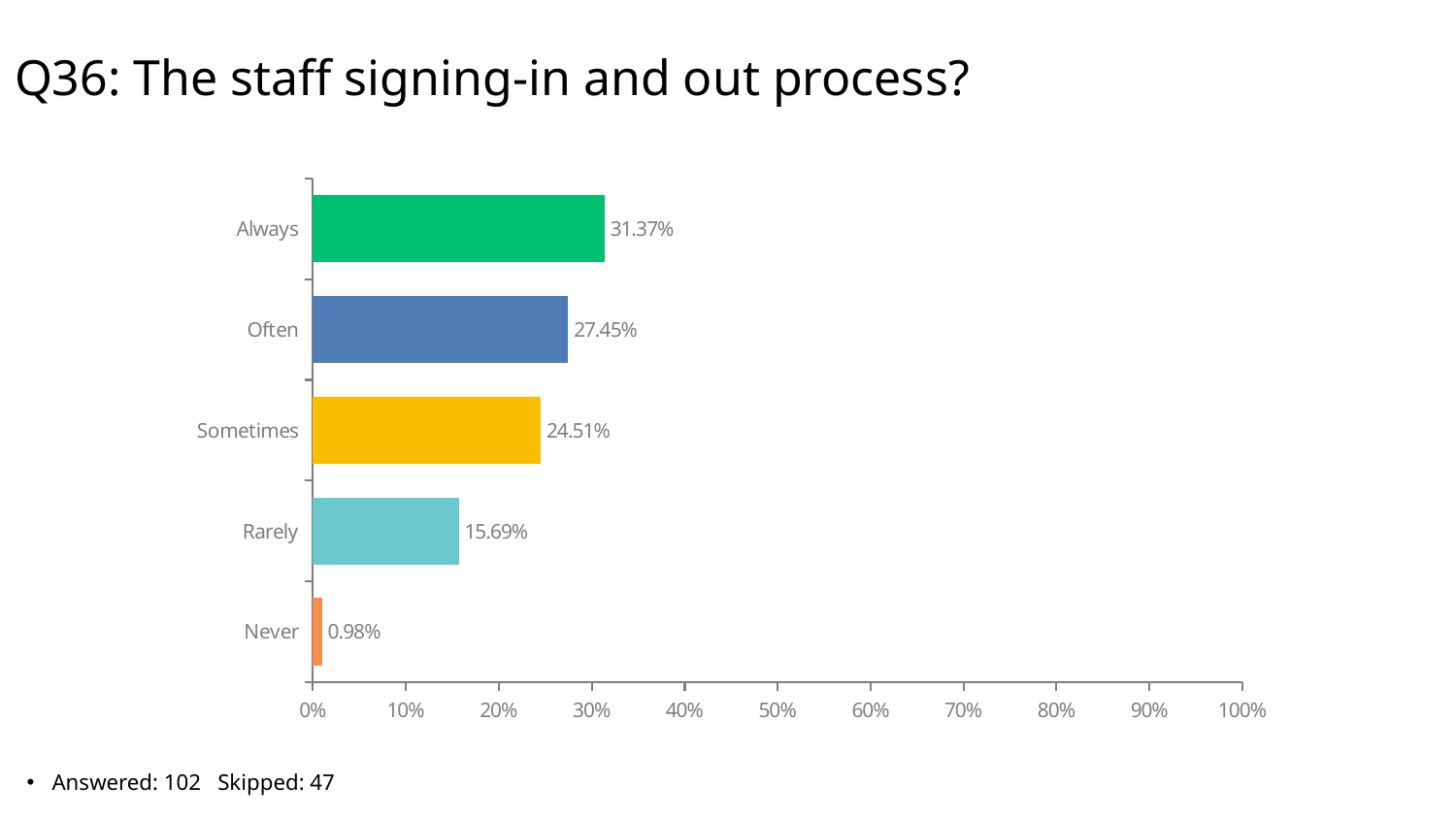
What is the title of the slide? Q36: The staff signing-in and out process? Which category has the lowest percentage? Never What type of chart is shown on the slide? Bar chart Which is larger, the value for "Often" or the value for "Rarely"? Often What percentage is shown for "Never"? 0.98% What percentage of respondents answered "Always"? 31.37% What is the value shown for "Sometimes"? 24.51% Is the value for "Rarely" greater or less than 20%? less Which category has the highest percentage? Always What is the difference in percentage points between "Always" and "Often"? 3.92 What is the difference in percentage points between "Sometimes" and "Rarely"? 8.82 How many categories are shown in the chart? 5